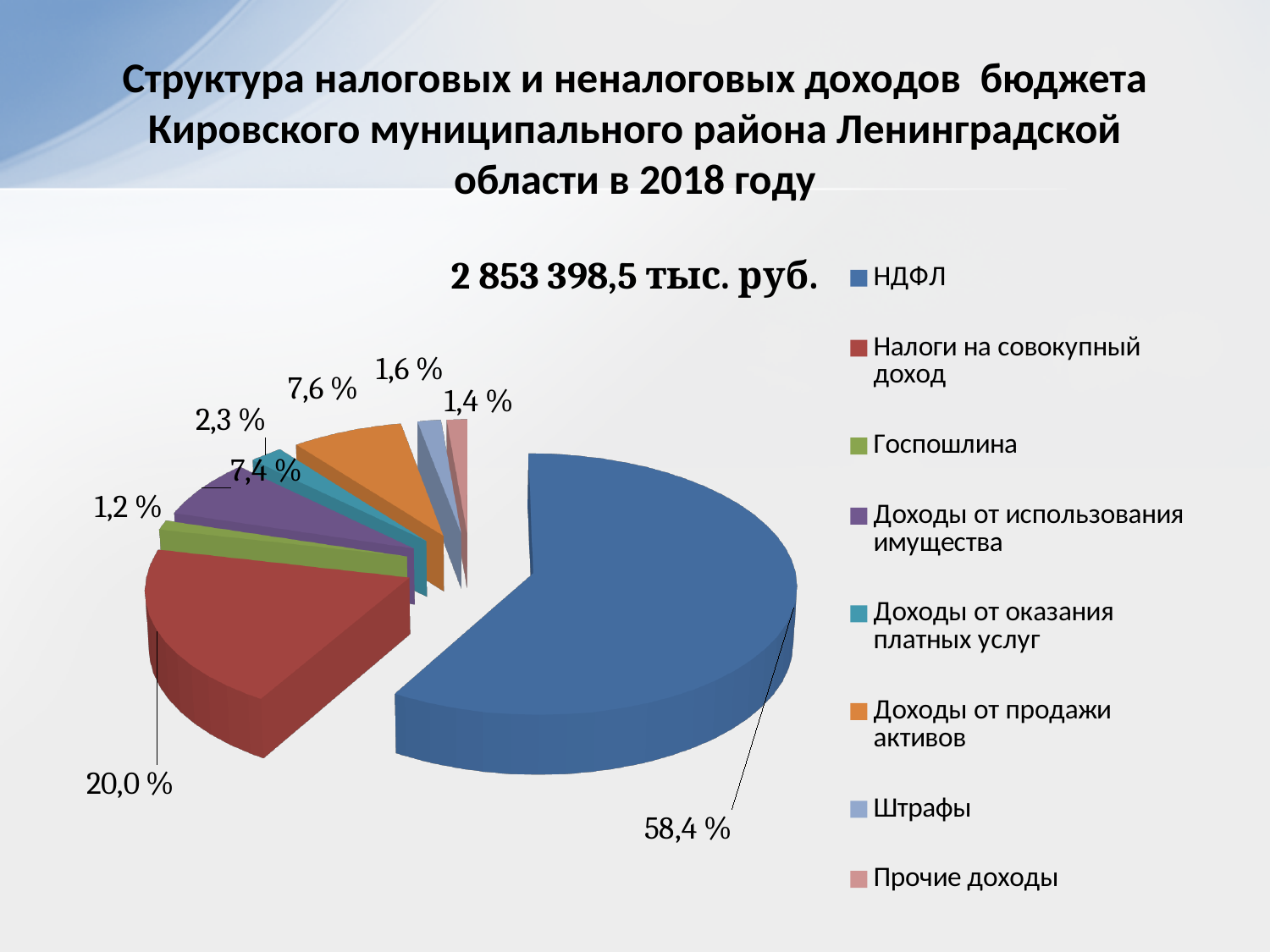
What kind of chart is shown on the slide? Pie chart What is the difference between the shares of НДФЛ and Налоги на совокупный доход? 38,4 % Which category has the largest slice of the pie? НДФЛ What is the value shown for Госпошлина? 1,2 % How many categories does the legend list? 8 What is the title shown above the pie chart? 2 853 398,5 тыс. руб. What is the value shown for Доходы от использования имущества? 7,4 % What share of the pie does Налоги на совокупный доход have? 20,0 % Which category has the smallest slice of the pie? Госпошлина What is the value shown for Доходы от продажи активов? 7,6 % What share of the pie does НДФЛ have? 58,4 % Which is larger, the share of Штрафы or the share of Прочие доходы? Штрафы